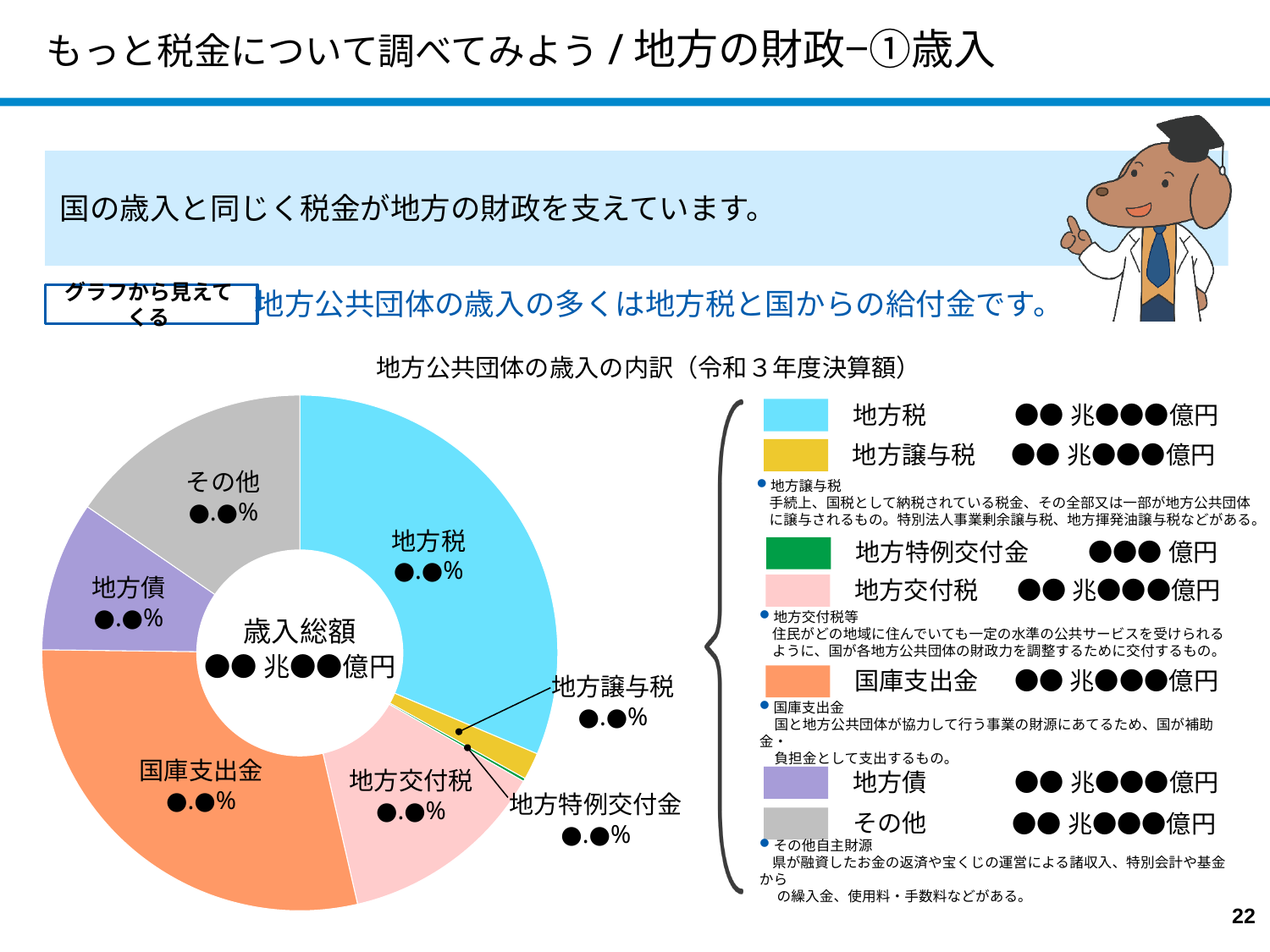
What is the title of the pie chart? 地方公共団体の歳入の内訳（令和３年度決算額） How many categories does the pie chart divide local government revenue into? 7 What colour is the 地方税 slice in the pie chart? Light blue Which has the larger share of the pie chart, 国庫支出金 or 地方債? 国庫支出金 What kind of chart is shown on the slide? Pie chart (donut) Which has the larger share of the pie chart, 国庫支出金 or 地方交付税? 国庫支出金 Which has the larger share of the pie chart, 地方譲与税 or 地方特例交付金? 地方譲与税 Which category has the largest share of the pie chart? 地方税 Which category has the smallest share of the pie chart? 地方特例交付金